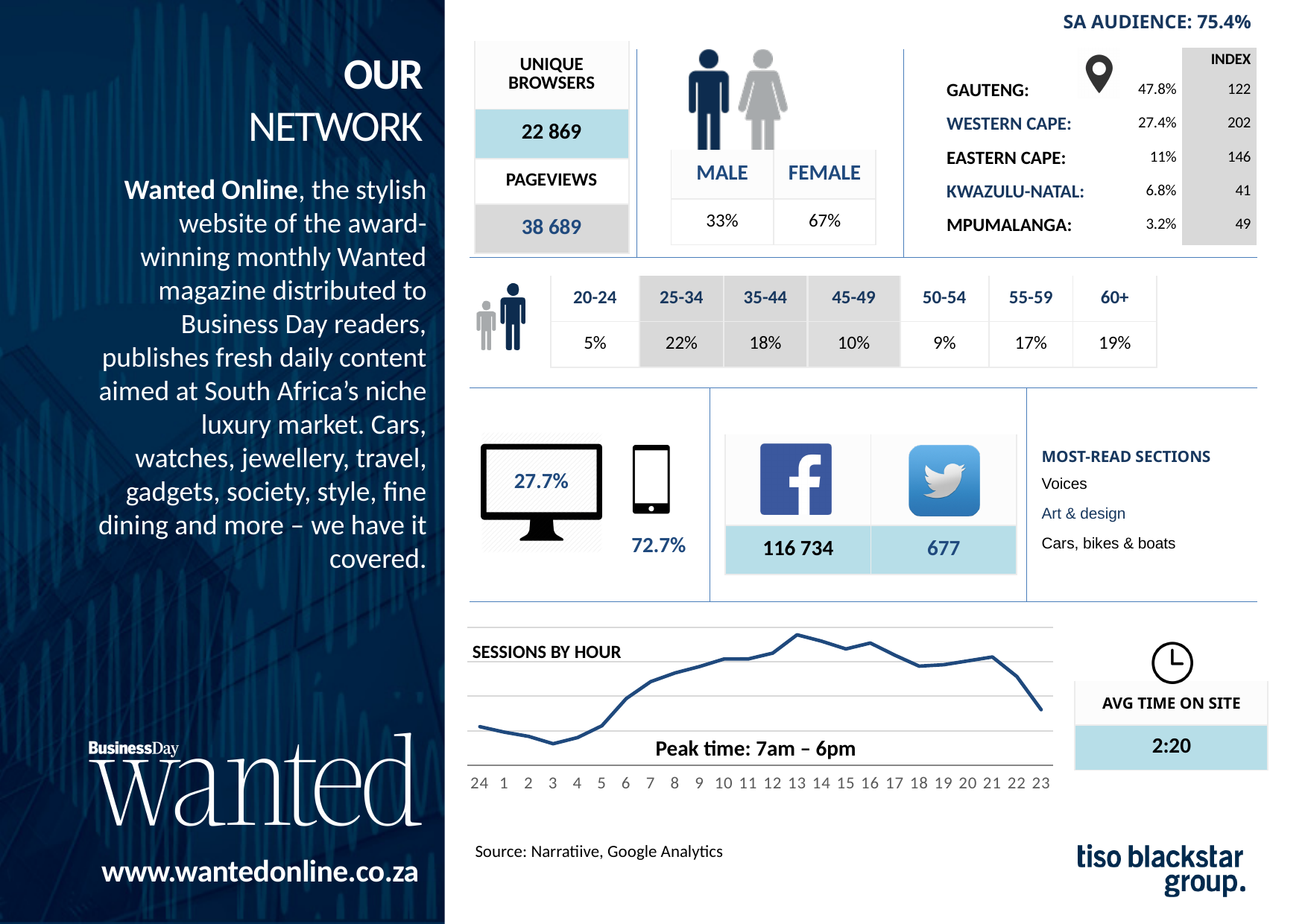
In the 'Sessions by hour' chart, at which hour do sessions reach their highest point? 13 In the 'Sessions by hour' chart, at which hour do sessions reach their lowest point? 3 In the 'Sessions by hour' chart, do sessions rise or fall between hour 21 and hour 23? fall In the 'Sessions by hour' chart, which hour has more sessions, hour 21 or hour 23? 21 How many hour points are plotted along the x axis of the 'Sessions by hour' chart? 24 What peak time is stated on the 'Sessions by hour' chart? 7am – 6pm What kind of chart is the 'Sessions by hour' chart? line chart In the 'Sessions by hour' chart, do sessions rise or fall between hour 3 and hour 13? rise In the 'Sessions by hour' chart, which hour has more sessions, hour 13 or hour 15? 13 What is the title of the line chart on the slide? SESSIONS BY HOUR In the 'Sessions by hour' chart, which hour has more sessions, hour 16 or hour 2? 16